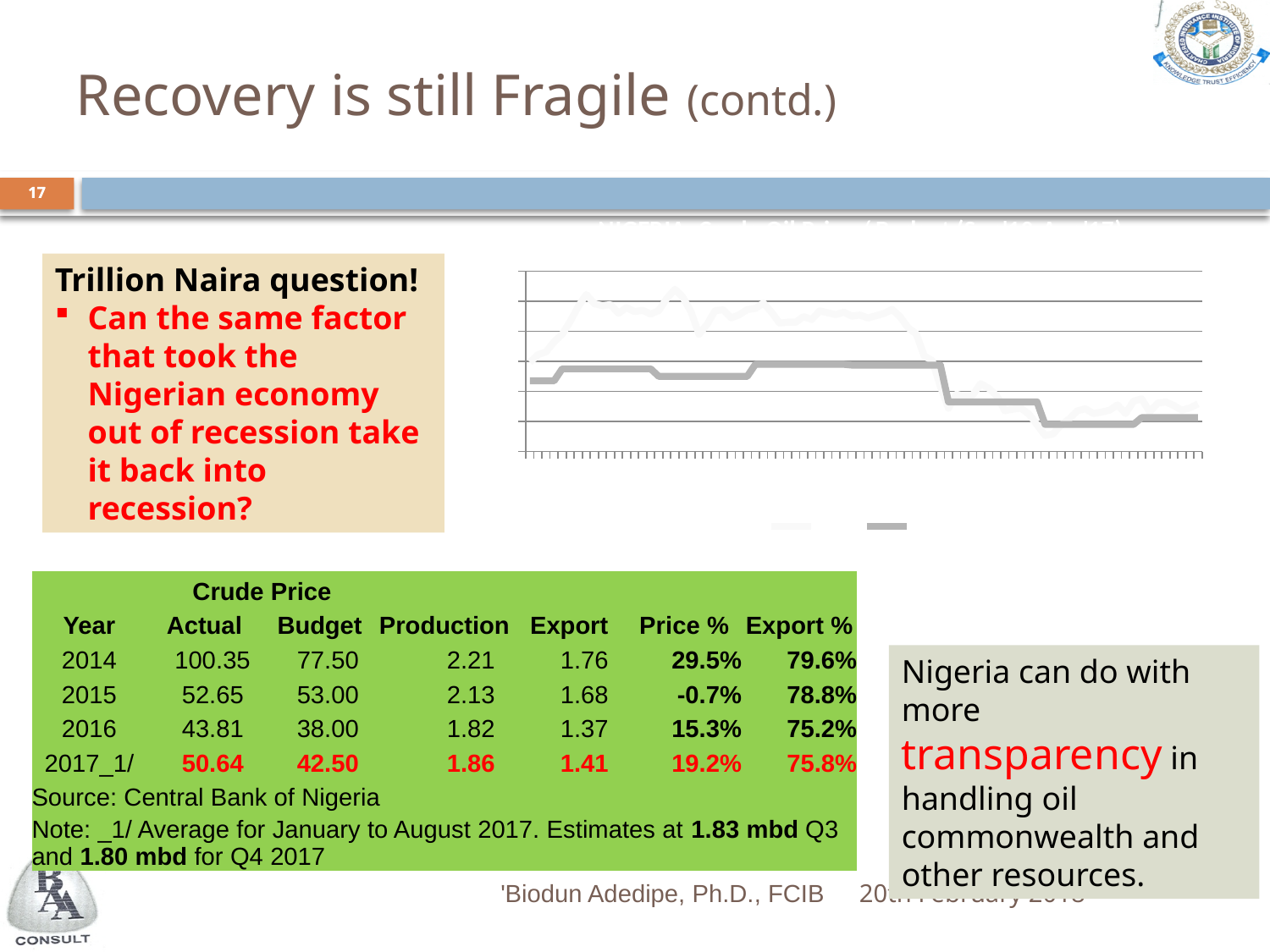
How many lines are plotted in the line chart? 2 What kind of chart is shown on the right side of the slide? line chart In the line chart, is the lighter line at the right end of the x axis higher or lower than at the left end? lower In the line chart, do the values of the darker grey stepped line rise or fall overall from left to right? fall How many series does the legend of the line chart list? 2